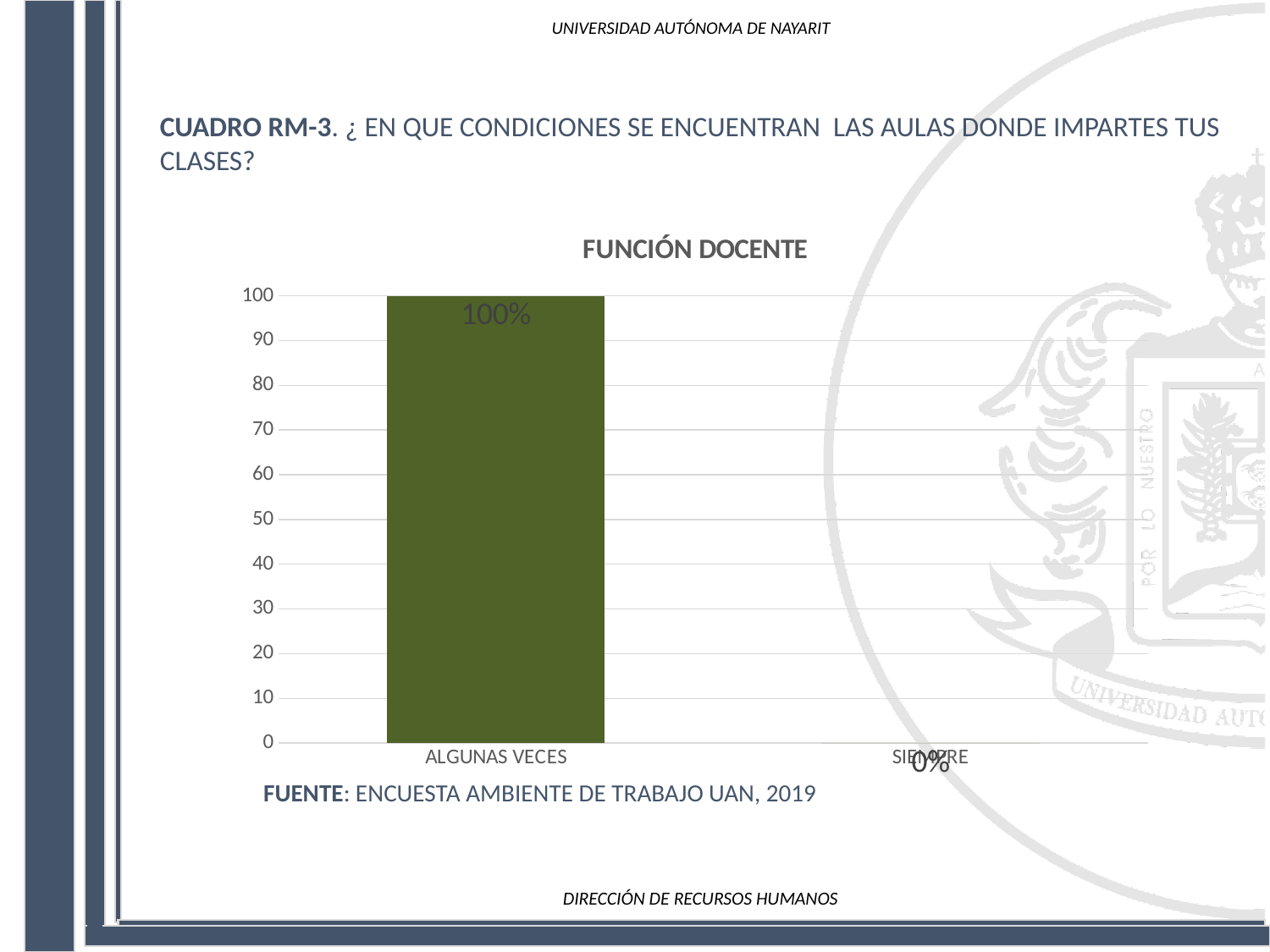
Is the value for ALGUNAS VECES greater or less than 50? greater What is the value for ALGUNAS VECES? 100% What is the title of the chart? FUNCIÓN DOCENTE How many categories are shown on the x axis? 2 Which is larger, the value for ALGUNAS VECES or the value for SIEMPRE? ALGUNAS VECES What is the difference between the values for ALGUNAS VECES and SIEMPRE? 100% Which category has the highest value? ALGUNAS VECES Which category has the lowest value? SIEMPRE What is the maximum value shown on the vertical axis? 100 What is the value for SIEMPRE? 0% What kind of chart is shown? bar chart